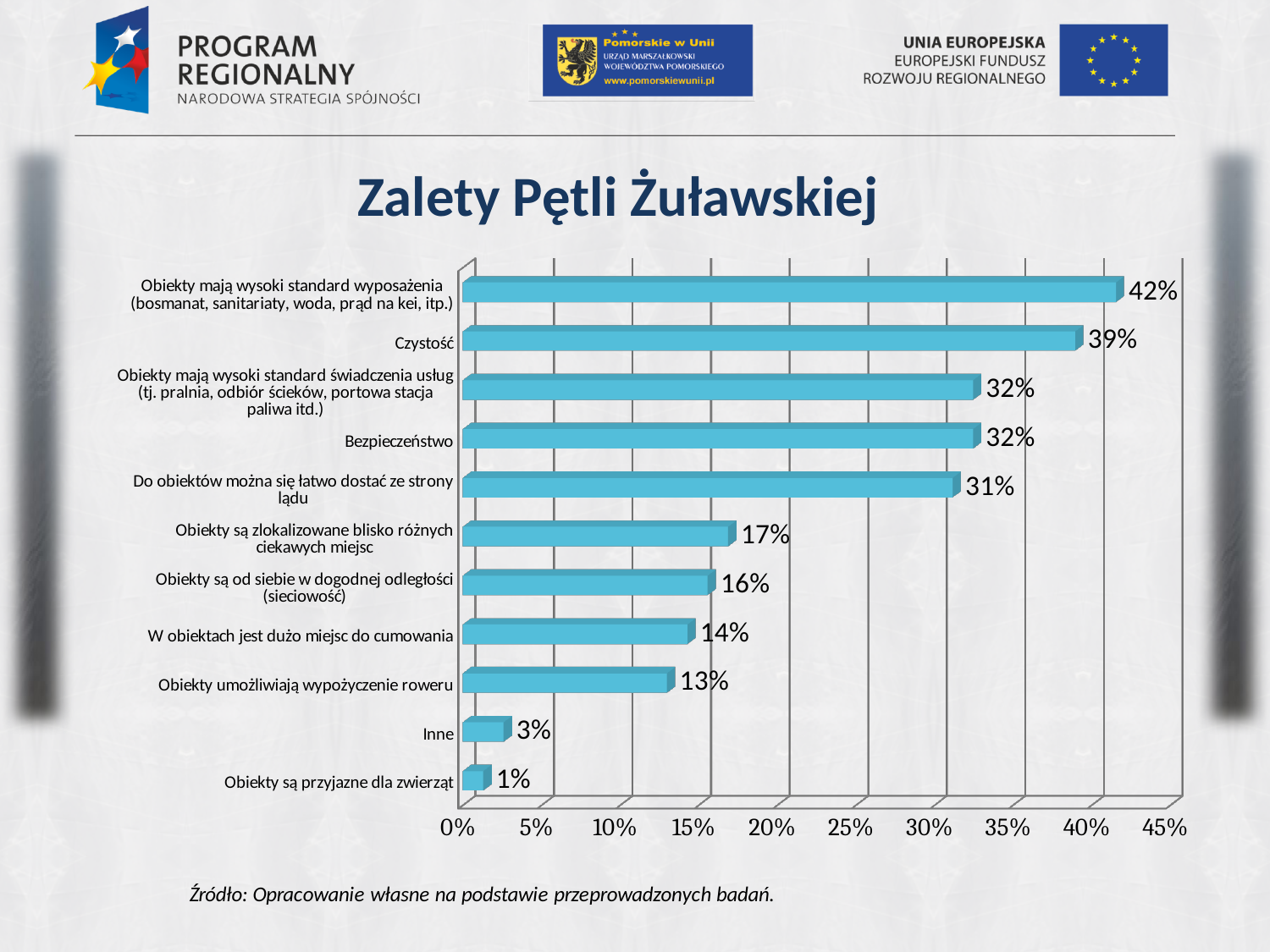
What is the value for "Obiekty umożliwiają wypożyczenie roweru"? 13% Which category has the lowest value? Obiekty są przyjazne dla zwierząt What is the value for "Czystość"? 39% Is the value for "Do obiektów można się łatwo dostać ze strony lądu" greater or less than 25%? greater How many categories are shown in the chart? 11 What is the value for "Inne"? 3% What is the value for "Bezpieczeństwo"? 32% Which is larger: the value for "Obiekty są zlokalizowane blisko różnych ciekawych miejsc" or the value for "Obiekty są od siebie w dogodnej odległości (sieciowość)"? Obiekty są zlokalizowane blisko różnych ciekawych miejsc What kind of chart is shown on the slide? bar chart Which category has the highest value? Obiekty mają wysoki standard wyposażenia (bosmanat, sanitariaty, woda, prąd na kei, itp.) What is the difference between the values for "Czystość" and "W obiektach jest dużo miejsc do cumowania"? 25% What is the title of the chart? Zalety Pętli Żuławskiej